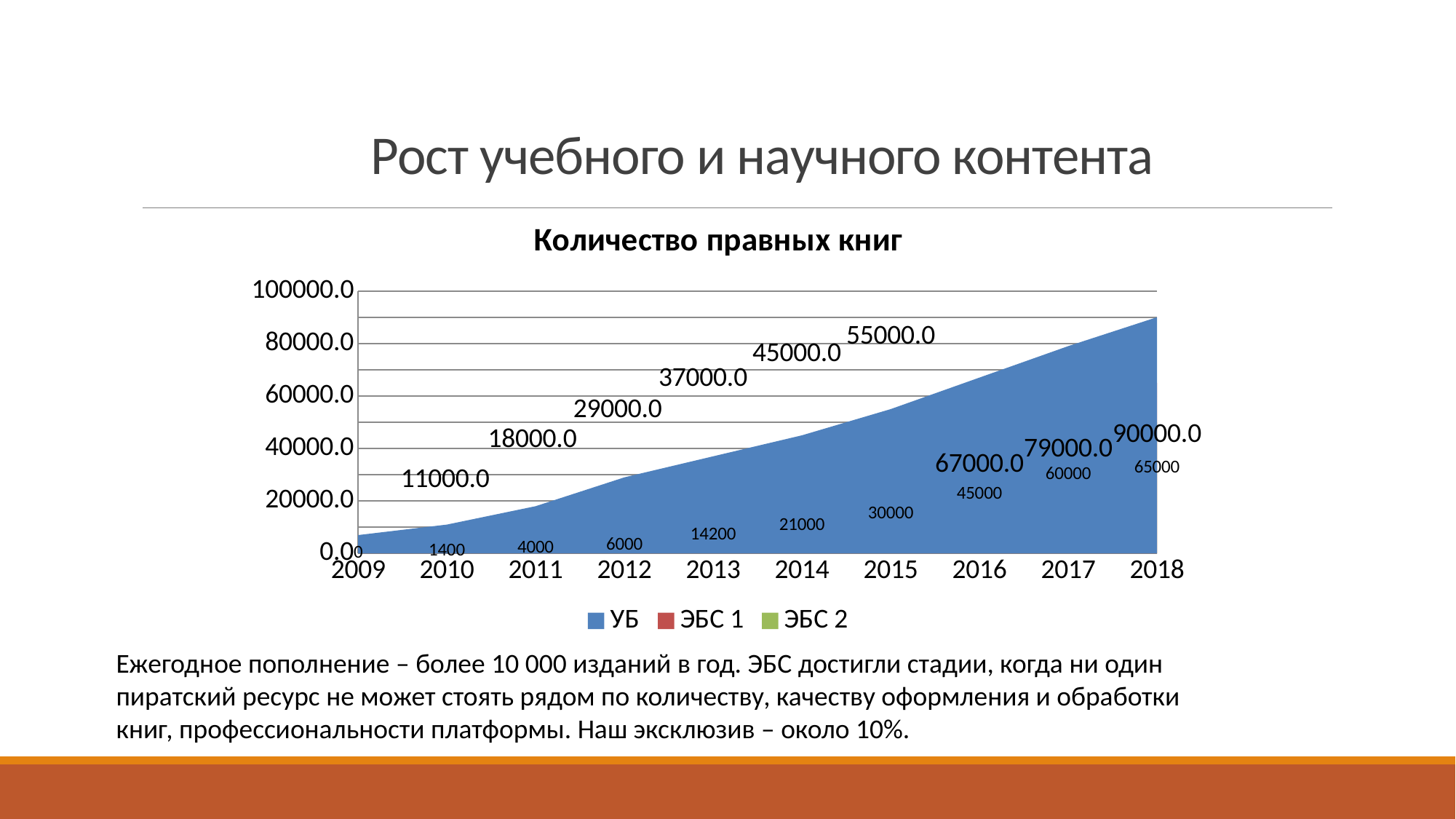
What is the title of the chart? Количество правных книг How many series does the legend list? 3 What is the value of the УБ series in 2014? 45000.0 What is the value of the УБ series in 2011? 18000.0 What kind of chart is shown on the slide? area chart Is the value of the УБ series in 2009 greater or less than 20000.0? less What is the difference between the УБ values for 2016 and 2015? 12000.0 How many years are shown on the x axis? 10 In which year is the УБ series highest? 2018 What is the difference between the УБ values for 2018 and 2017? 11000.0 What is the value of the УБ series in 2018? 90000.0 Does the УБ series rise or fall from 2009 to 2018? rise